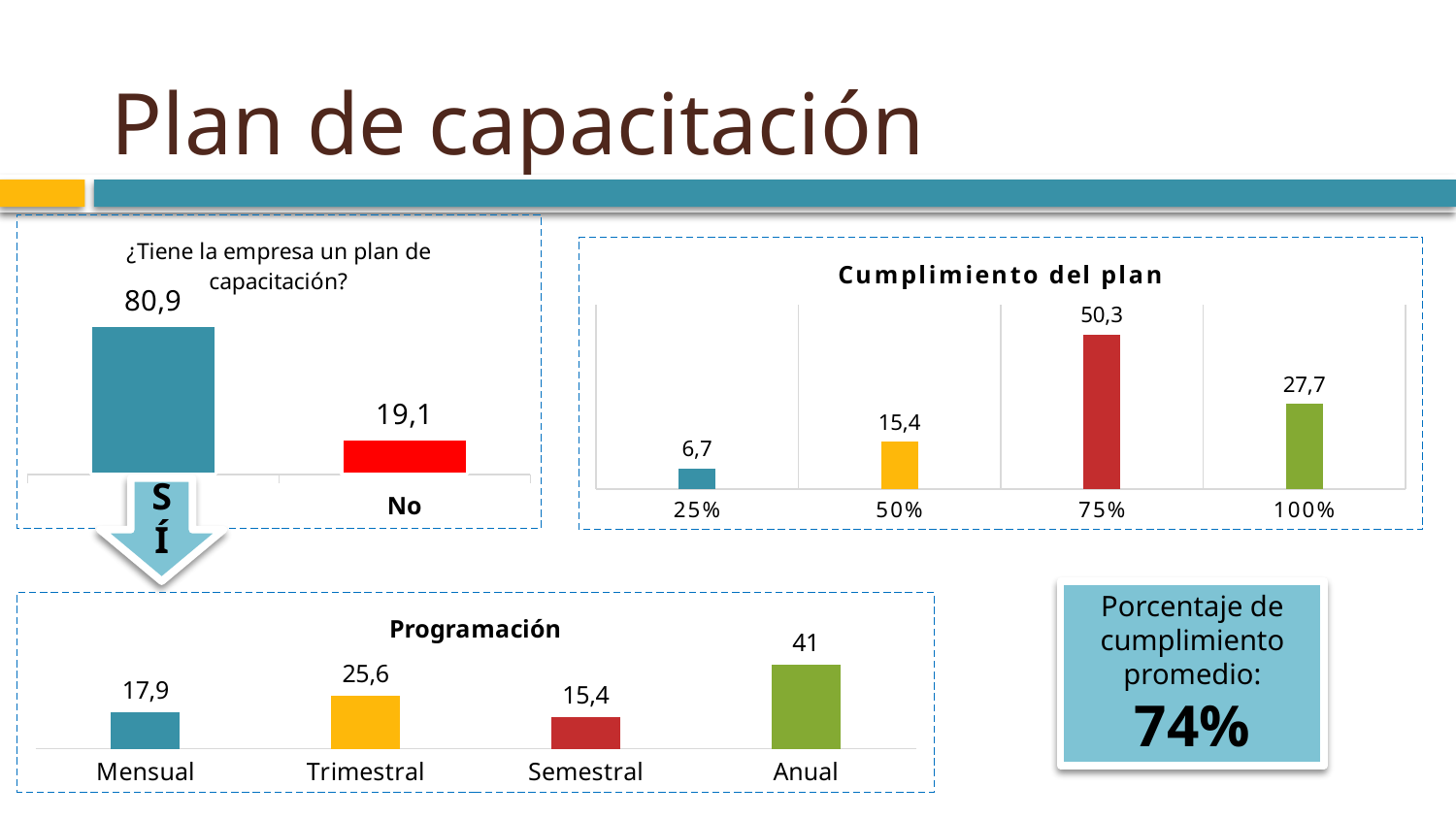
In the chart "¿Tiene la empresa un plan de capacitación?", what is the difference between the values for Sí and No? 61,8 In the "Programación" chart, what is the value for Anual? 41 In the "Programación" chart, which category has the lowest value? Semestral In the "Cumplimiento del plan" chart, how many categories are shown? 4 In the "Cumplimiento del plan" chart, what is the difference between the values for 75% and 100%? 22,6 In the "Programación" chart, which is larger, Mensual or Trimestral? Trimestral In the chart "¿Tiene la empresa un plan de capacitación?", what is the value for Sí? 80,9 What kind of chart is the "Programación" chart? Bar chart In the "Cumplimiento del plan" chart, which category has the highest value? 75% In the "Cumplimiento del plan" chart, what is the value for 75%? 50,3 In the chart "¿Tiene la empresa un plan de capacitación?", what is the value for No? 19,1 In the "Cumplimiento del plan" chart, which category has the lowest value? 25%